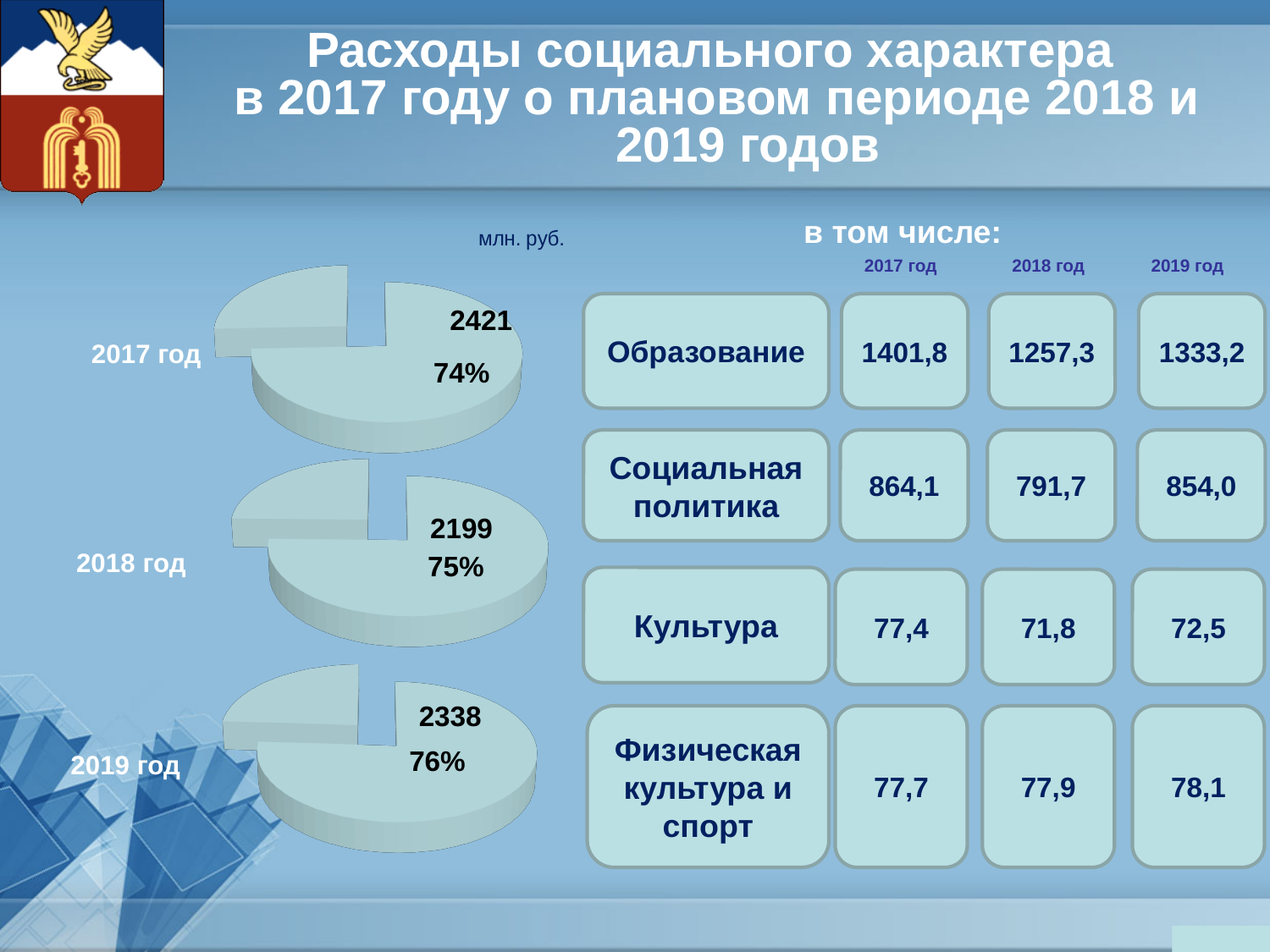
Which is larger: the printed value in the 2019 год pie chart or the 2017 год pie chart? 2017 год In the pie chart for 2017 год, what value is printed on the highlighted slice? 2421 Across the three pie charts, which year has the highest printed value on its highlighted slice? 2017 год How many pie charts are shown on the slide? 3 In the pie chart for 2019 год, what value is printed on the highlighted slice? 2338 Do the percentages printed on the pie charts rise or fall from 2017 год to 2019 год? Rise What is the difference between the printed value in the 2017 год pie chart (2421) and the 2018 год pie chart (2199)? 222 In the pie chart for 2018 год, what percentage is printed on the highlighted slice? 75% In the pie chart for 2017 год, what share does the highlighted slice represent? 74% What kind of charts are shown on the left side of the slide? Pie charts In the pie chart for 2019 год, what share does the highlighted slice represent? 76% Across the three pie charts, which year has the lowest printed value on its highlighted slice? 2018 год